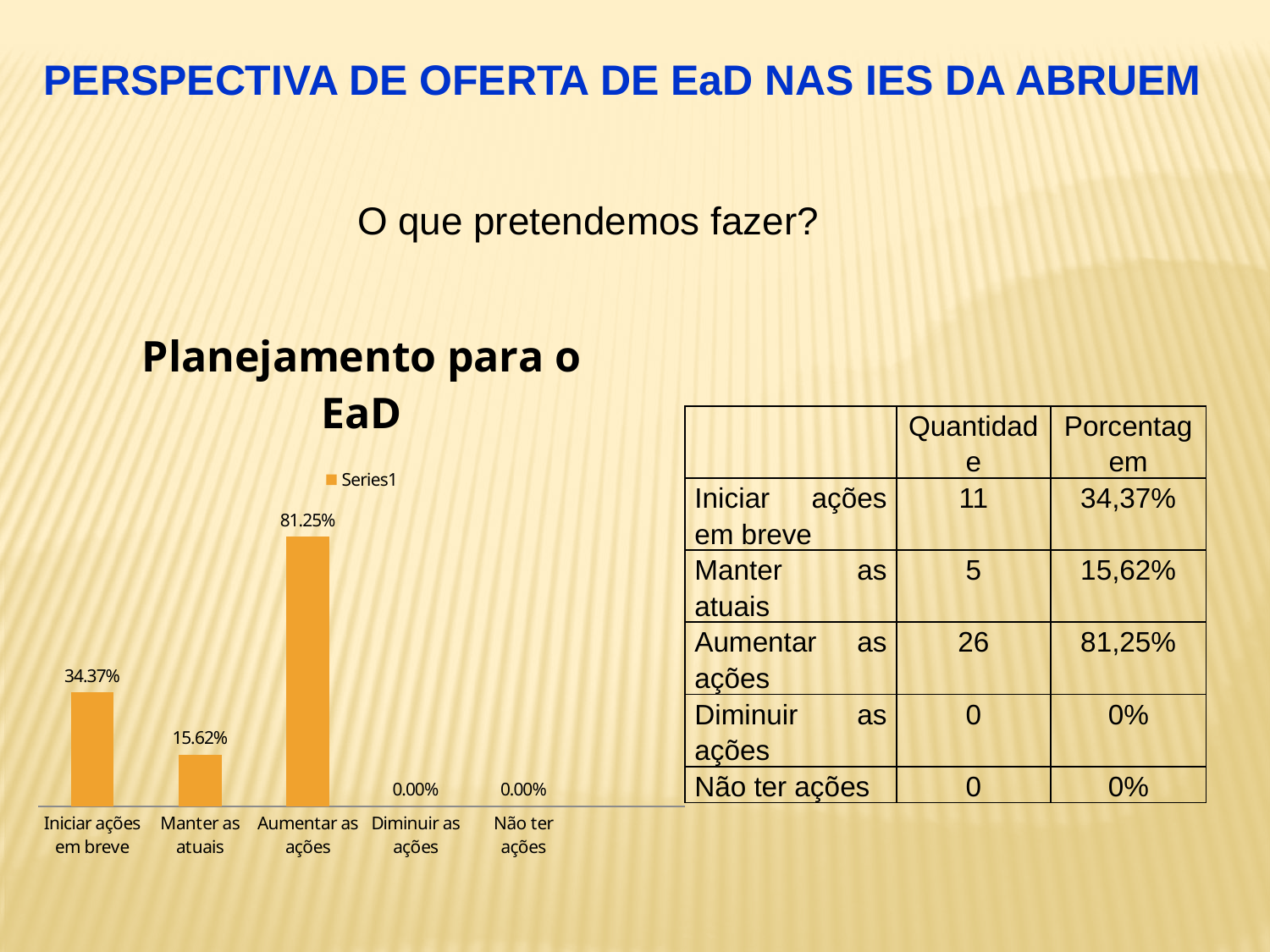
What is the value for "Iniciar ações em breve" in the chart? 34.37% What is the value for "Diminuir as ações" in the chart? 0.00% What is the difference between the values for "Iniciar ações em breve" and "Manter as atuais"? 18.75% How many series does the chart legend list? 1 How many categories are shown on the x axis of the chart? 5 What is the value for "Aumentar as ações" in the chart? 81.25% Which is larger, the value for "Iniciar ações em breve" or the value for "Manter as atuais"? Iniciar ações em breve What is the title of the chart? Planejamento para o EaD What is the difference between the values for "Aumentar as ações" and "Iniciar ações em breve"? 46.88% What is the value for "Manter as atuais" in the chart? 15.62% Which category has the highest value in the chart? Aumentar as ações What kind of chart is shown on the slide? Bar chart